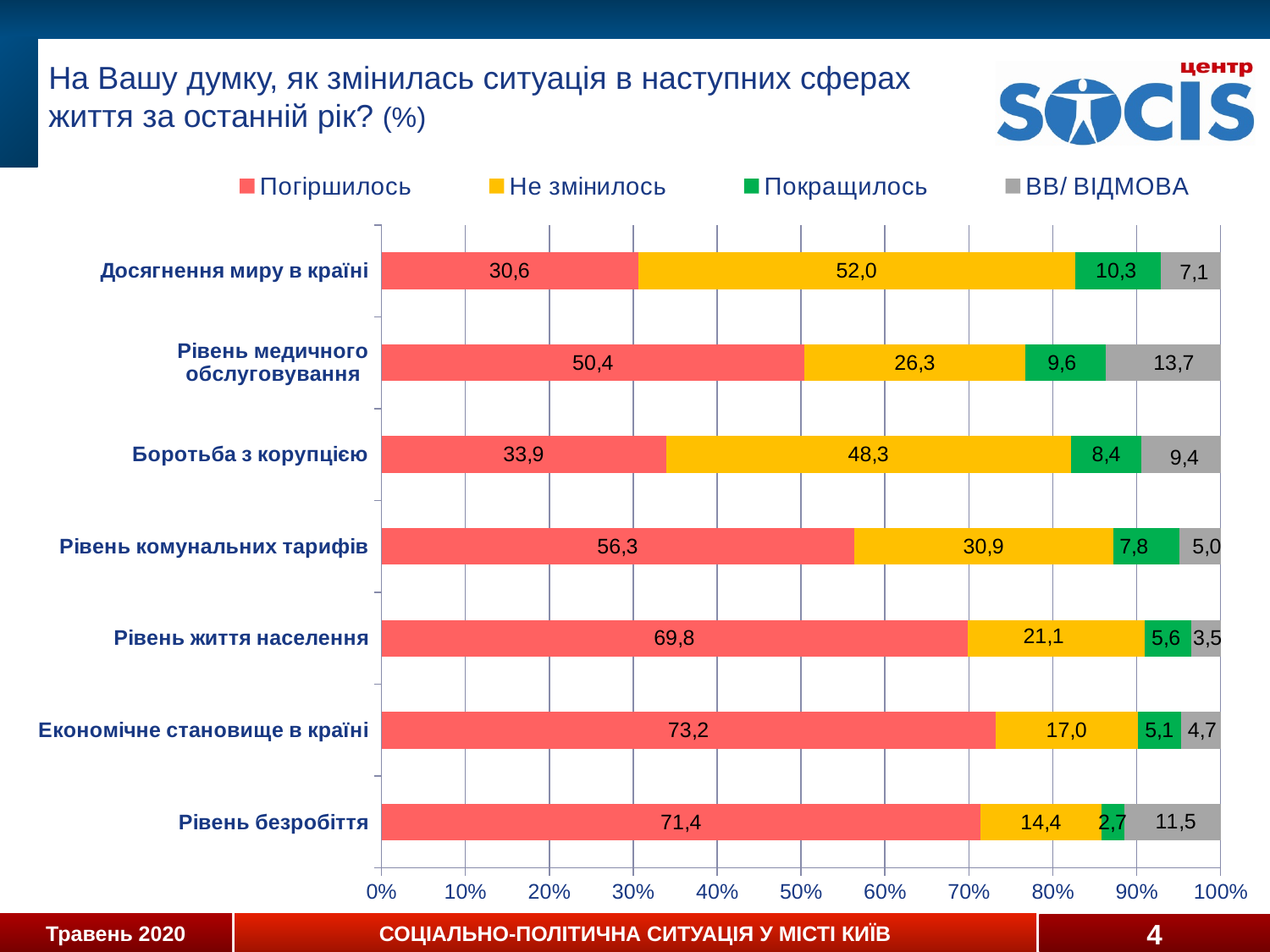
Which category has the lowest value for "Покращилось"? Рівень безробіття What is the value of "ВВ/ ВІДМОВА" for "Рівень безробіття"? 11,5 Which category has the highest value for "Не змінилось"? Досягнення миру в країні Which is larger: the "ВВ/ ВІДМОВА" value for "Рівень медичного обслуговування" or for "Боротьба з корупцією"? Рівень медичного обслуговування What is the total of the stacked bar for "Рівень комунальних тарифів"? 100,0 What kind of chart is shown on the slide? Stacked bar chart What is the value of "Не змінилось" for "Боротьба з корупцією"? 48,3 How many series does the legend list? 4 How many categories are shown on the chart? 7 Which category has the highest value for "Погіршилось"? Економічне становище в країні What is the value of "Погіршилось" for "Досягнення миру в країні"? 30,6 What is the difference between the "Погіршилось" values for "Економічне становище в країні" and "Досягнення миру в країні"? 42,6